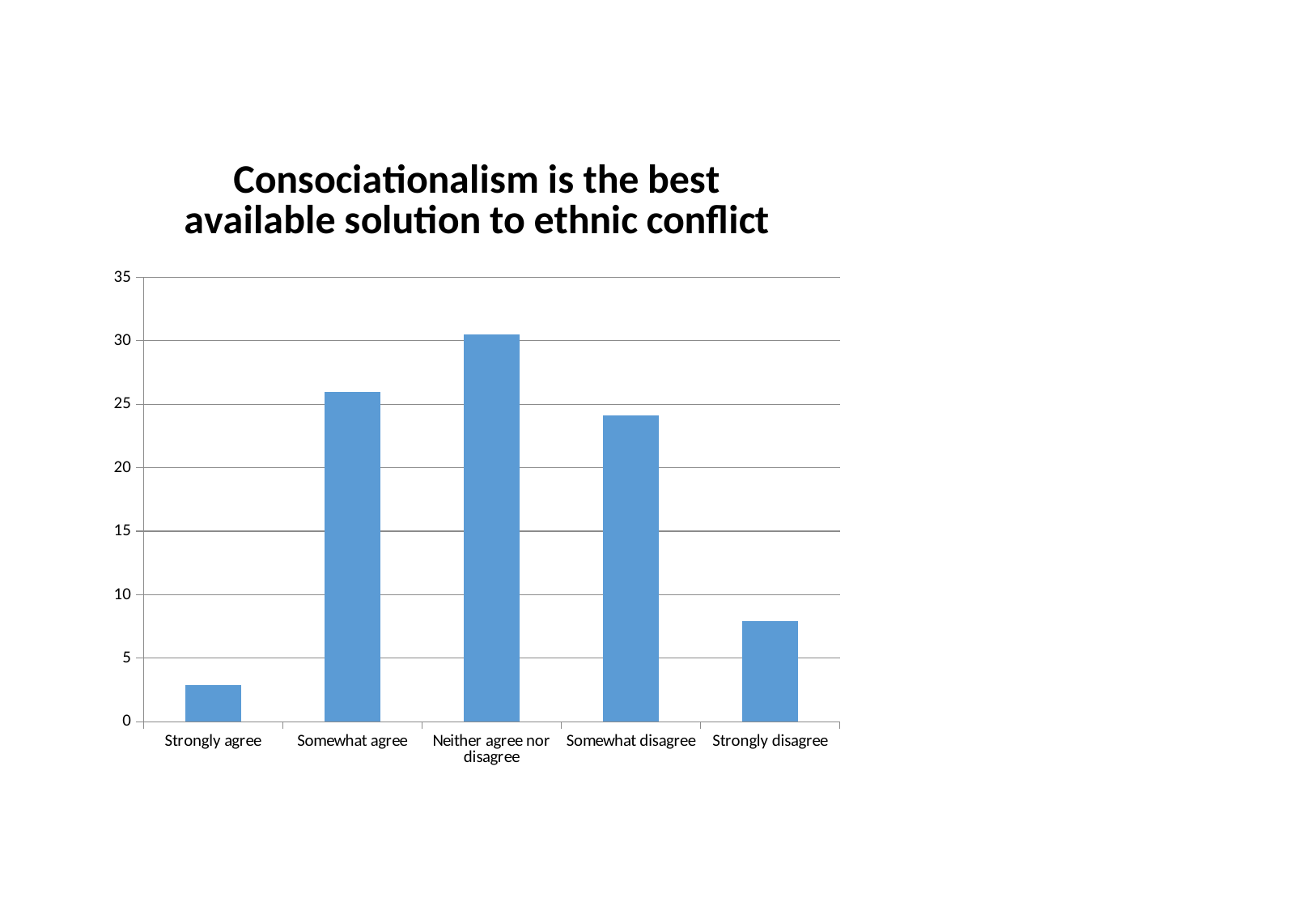
Is the value for Somewhat disagree greater or less than 25? less What is the title of the chart? Consociationalism is the best available solution to ethnic conflict Which is larger, the value for Strongly agree or the value for Strongly disagree? Strongly disagree Is the value for Somewhat agree greater or less than 25? greater What kind of chart is shown on the slide? Bar chart Which is larger, the value for Somewhat agree or the value for Somewhat disagree? Somewhat agree How many categories are shown on the x axis? 5 Is the value for Strongly disagree greater or less than 10? less Which category has the highest value? Neither agree nor disagree Which category has the lowest value? Strongly agree